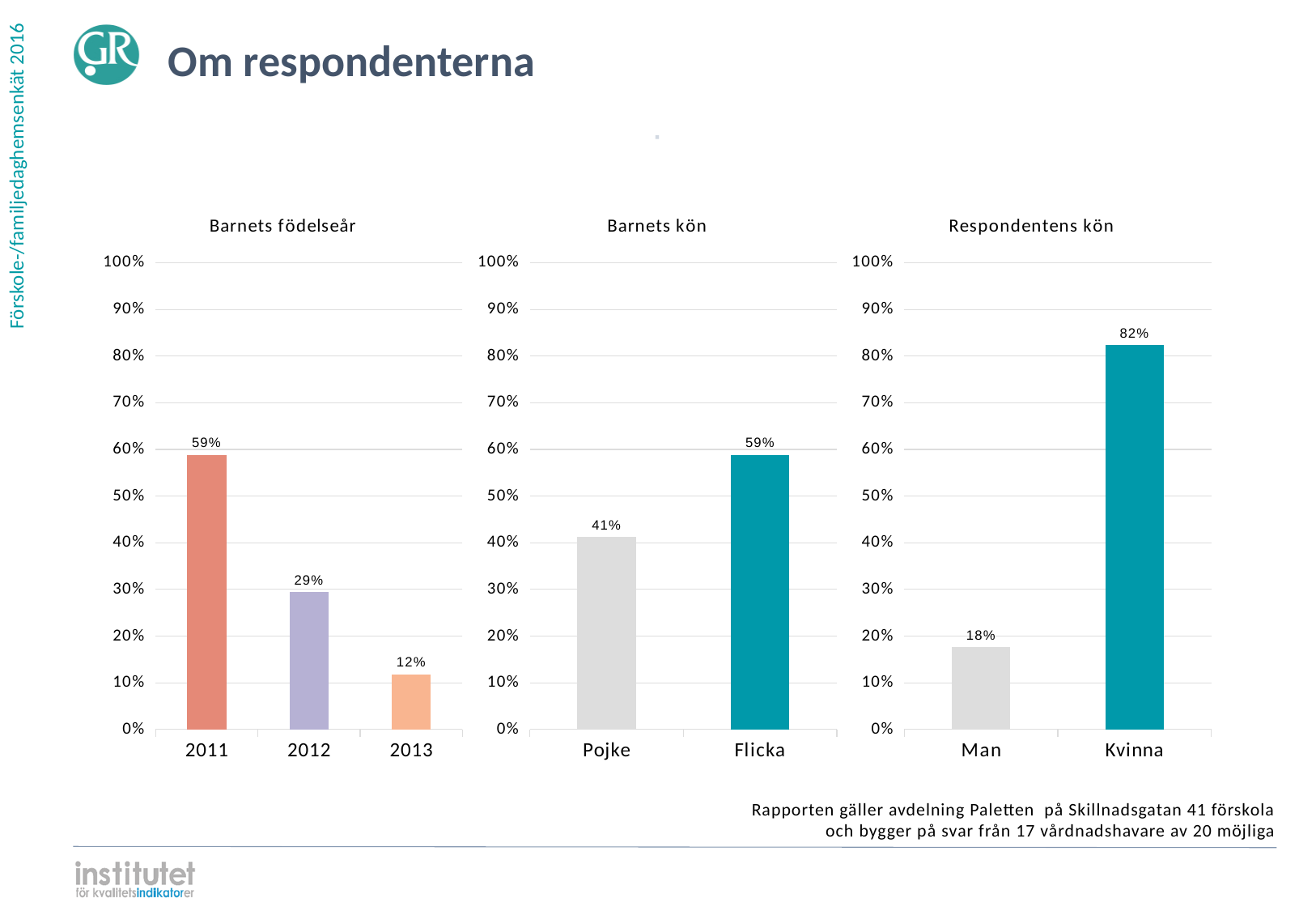
What kind of chart is the 'Respondentens kön' chart? bar chart In the 'Barnets kön' chart, which category is higher, Pojke or Flicka? Flicka In the 'Barnets födelseår' chart, how many categories are shown on the x axis? 3 In the 'Barnets kön' chart, what is the difference between Flicka and Pojke? 18% In the 'Barnets födelseår' chart, what is the difference between the values for 2011 and 2012? 30% In the 'Barnets födelseår' chart, do the values rise or fall from 2011 to 2013? fall In the 'Respondentens kön' chart, which category has the highest value? Kvinna In the 'Respondentens kön' chart, what is the value for Kvinna? 82% In the 'Barnets kön' chart, what is the value for Pojke? 41% In the 'Barnets födelseår' chart, what is the value for 2011? 59% In the 'Respondentens kön' chart, what is the difference between Kvinna and Man? 64% In the 'Barnets födelseår' chart, which birth year has the lowest value? 2013